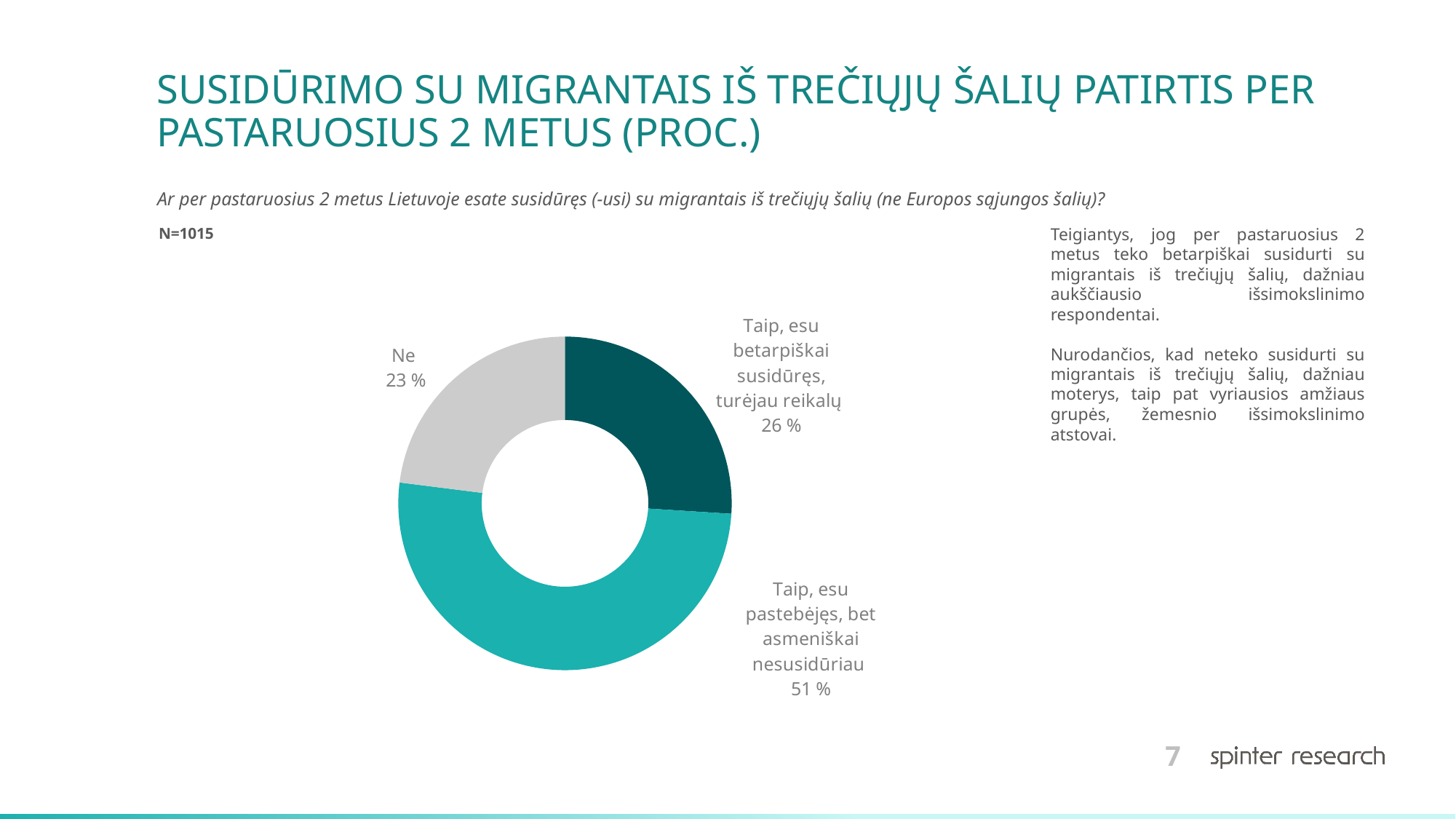
How many categories does the chart show? 3 What kind of chart is shown on the slide? Pie chart (doughnut) What is the difference between "Taip, esu betarpiškai susidūręs, turėjau reikalų" and "Ne"? 3 % What is the difference between "Taip, esu pastebėjęs, bet asmeniškai nesusidūriau" and "Ne"? 28 % What colour is the "Ne" slice? Grey What is the sample size (N) shown on the slide? N=1015 What is the value for "Taip, esu betarpiškai susidūręs, turėjau reikalų"? 26 % Which category has the largest share? Taip, esu pastebėjęs, bet asmeniškai nesusidūriau Which is larger: "Taip, esu betarpiškai susidūręs, turėjau reikalų" or "Ne"? Taip, esu betarpiškai susidūręs, turėjau reikalų What is the value for "Ne"? 23 % Which category has the smallest share? Ne What is the value for "Taip, esu pastebėjęs, bet asmeniškai nesusidūriau"? 51 %